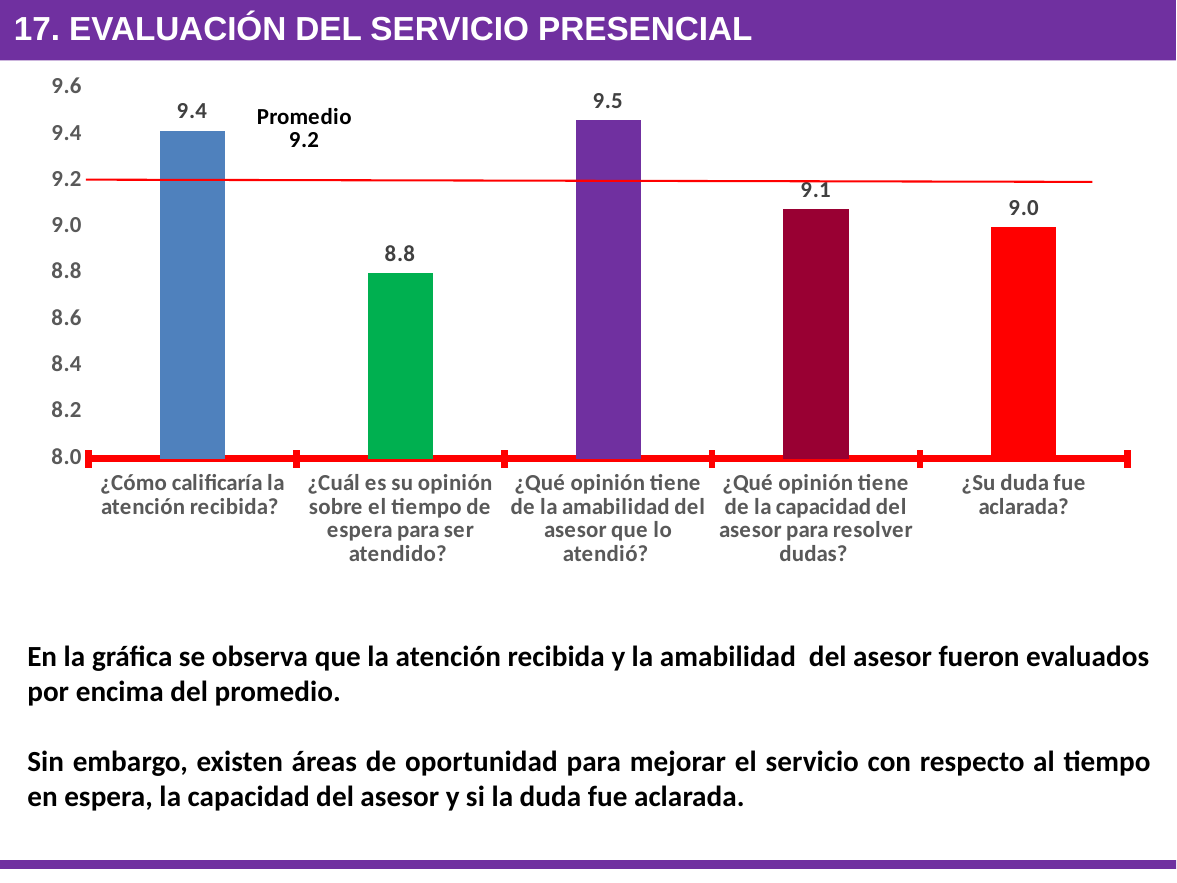
What is the value of the 'Promedio' line shown on the chart? 9.2 Which category has the lowest value? ¿Cuál es su opinión sobre el tiempo de espera para ser atendido? What is the difference between the value for '¿Qué opinión tiene de la amabilidad del asesor que lo atendió?' and the value for '¿Cuál es su opinión sobre el tiempo de espera para ser atendido?'? 0.7 Is the value for '¿Qué opinión tiene de la capacidad del asesor para resolver dudas?' greater or less than 9.2? less What is the title of the slide containing the chart? 17. EVALUACIÓN DEL SERVICIO PRESENCIAL What is the value for '¿Cómo calificaría la atención recibida?'? 9.4 Which is larger: the value for '¿Cómo calificaría la atención recibida?' or the value for '¿Qué opinión tiene de la capacidad del asesor para resolver dudas?'? ¿Cómo calificaría la atención recibida? What kind of chart is shown on the slide? bar chart Which category has the highest value? ¿Qué opinión tiene de la amabilidad del asesor que lo atendió? What is the value for '¿Cuál es su opinión sobre el tiempo de espera para ser atendido?'? 8.8 What is the value for '¿Su duda fue aclarada?'? 9.0 How many categories are shown on the chart? 5